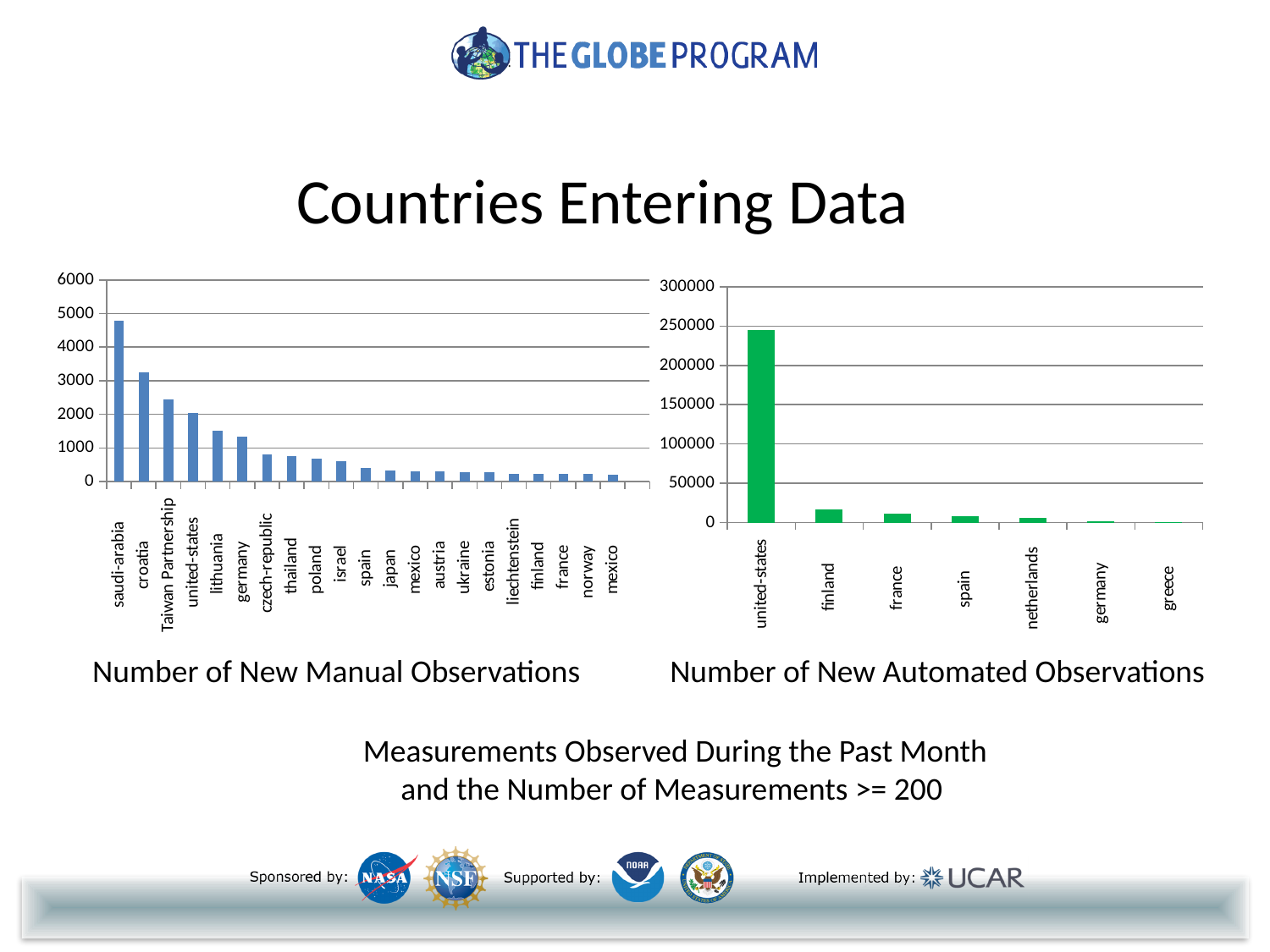
In the Number of New Manual Observations chart, what kind of chart is used? bar chart In the Number of New Manual Observations chart, is the value for croatia greater or less than 3000? greater In the Number of New Automated Observations chart, which country has the lowest value? greece In the Number of New Automated Observations chart, which country has the highest value? united-states In the Number of New Automated Observations chart, is the value for united-states greater or less than 200000? greater In the Number of New Manual Observations chart, is the value for saudi-arabia greater or less than 4000? greater In the Number of New Manual Observations chart, which country has the highest value? saudi-arabia In the Number of New Automated Observations chart, which is larger, finland or france? finland In the Number of New Manual Observations chart, do the values rise or fall from left to right? fall In the Number of New Manual Observations chart, which is larger, croatia or Taiwan Partnership? croatia In the Number of New Automated Observations chart, how many countries are shown? 7